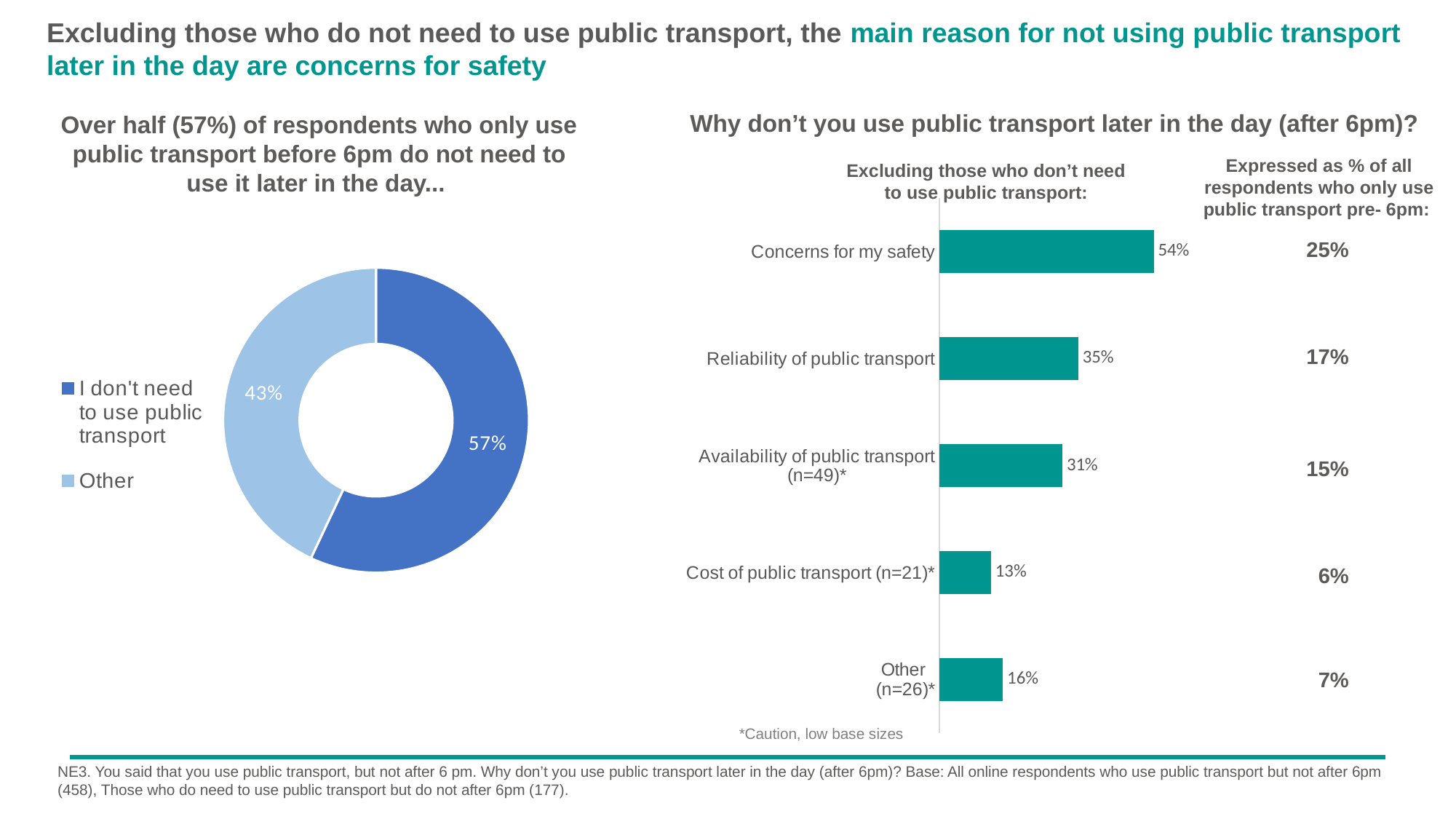
In the bar chart 'Why don't you use public transport later in the day (after 6pm)?', what is the value for 'Concerns for my safety'? 54% In the bar chart 'Why don't you use public transport later in the day (after 6pm)?', what is the value for 'Concerns for my safety' expressed as % of all respondents who only use public transport pre-6pm? 25% In the bar chart 'Why don't you use public transport later in the day (after 6pm)?', which is larger: 'Availability of public transport (n=49)*' or 'Other (n=26)*'? Availability of public transport (n=49)* In the bar chart 'Why don't you use public transport later in the day (after 6pm)?', how many categories are plotted? 5 In the bar chart 'Why don't you use public transport later in the day (after 6pm)?', what is the value for 'Reliability of public transport'? 35% What kind of chart is shown on the left of the slide? Donut (pie) chart In the donut chart on the left, what share of respondents say they don't need to use public transport? 57% In the donut chart on the left, how many categories does the legend list? 2 In the bar chart 'Why don't you use public transport later in the day (after 6pm)?', which category has the highest value? Concerns for my safety In the bar chart 'Why don't you use public transport later in the day (after 6pm)?', what is the difference between 'Concerns for my safety' and 'Reliability of public transport'? 19 percentage points In the bar chart 'Why don't you use public transport later in the day (after 6pm)?', which category has the lowest value? Cost of public transport (n=21)* In the donut chart on the left, what share of respondents fall into the 'Other' category? 43%